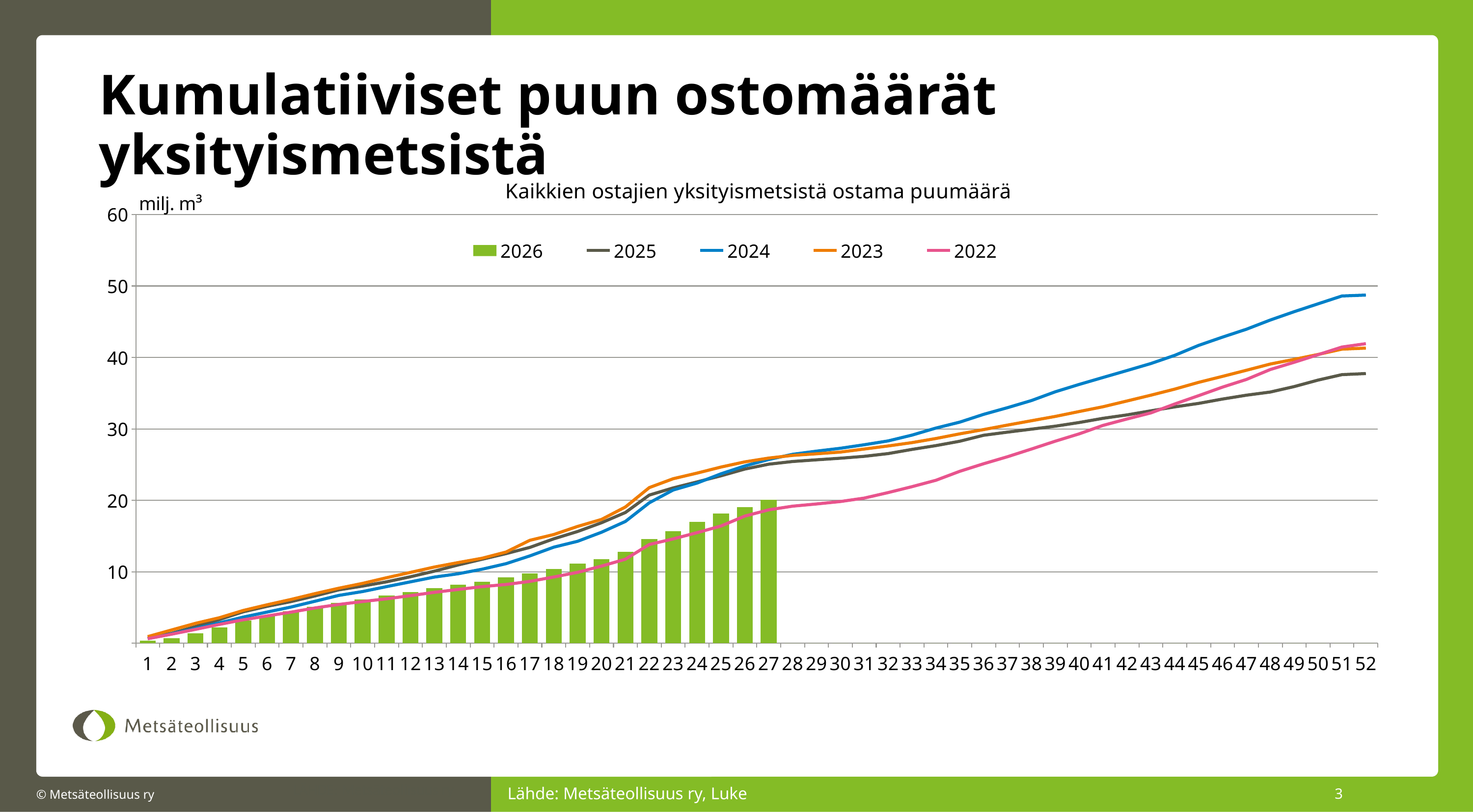
Is the value for 2024 at week 52 greater or less than 40? greater What kind of chart is this? Combined bar and line chart How many series does the legend list? 5 Which series has the lowest value at week 52? 2025 Which series has the highest value at week 52? 2024 How many weeks are shown on the x axis? 52 Up to which week are bars plotted for 2026? 27 Do the values for each series rise or fall along the x axis? rise Is the value for 2022 at week 35 greater or less than 30? less Is the value for 2025 at week 52 greater or less than 40? less At week 52, which is larger, the value for 2024 or the value for 2025? 2024 What unit is shown on the y axis? milj. m³